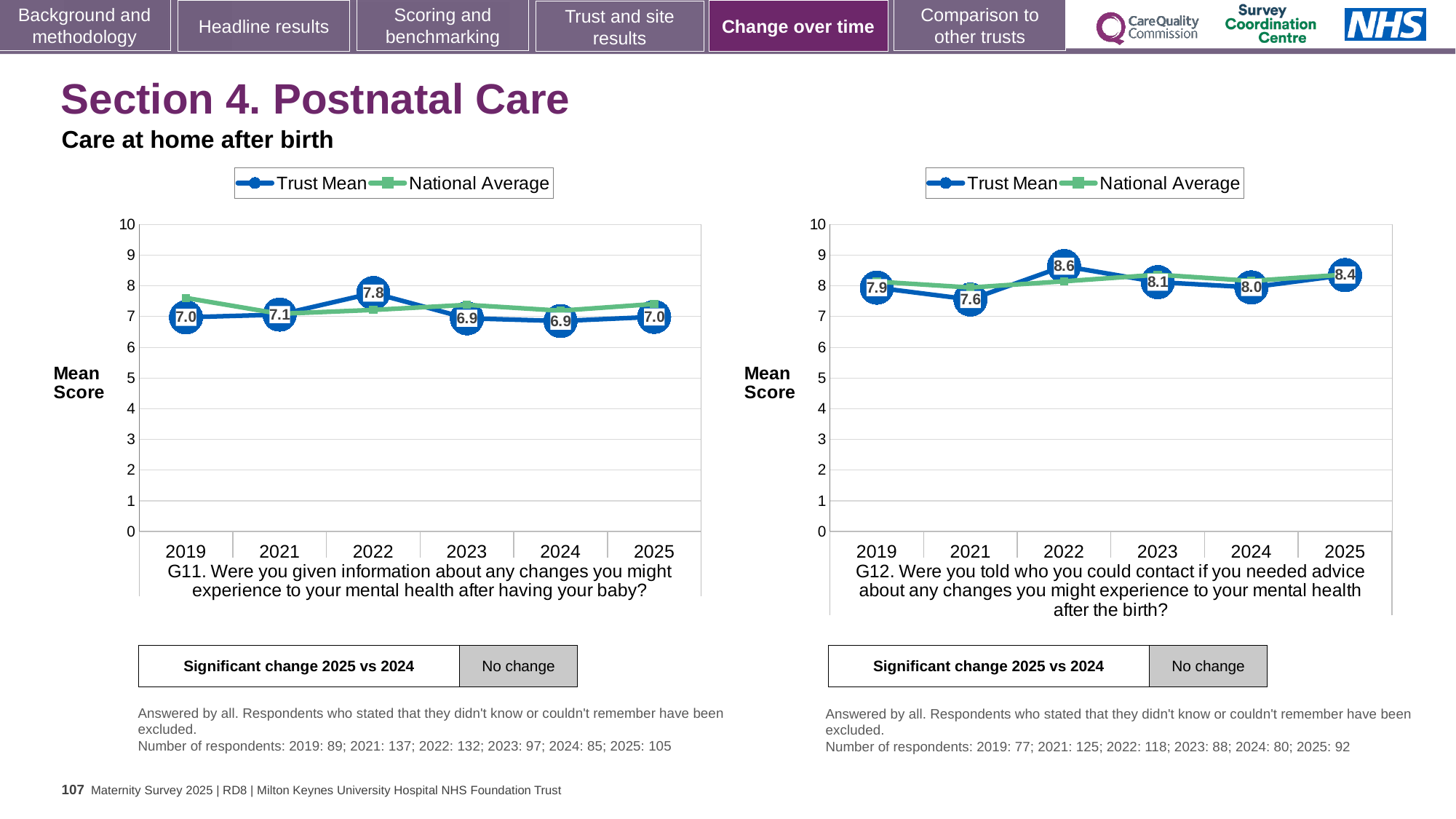
How many years are shown on the x axis of the left chart (G11)? 6 What type of chart is used for G11 on the left? Line chart On the right chart (G12), what is the difference between the Trust Mean scores for 2022 and 2021? 1.0 How many series does the legend of the right chart (G12) list? 2 On the left chart (G11), what is the Trust Mean score for 2022? 7.8 What does the 'Significant change 2025 vs 2024' box below the left chart (G11) say? No change On the left chart (G11), which year has the highest Trust Mean score? 2022 On the right chart (G12), does the Trust Mean score rise or fall from 2024 to 2025? rise On the right chart (G12), is the National Average for 2019 greater or less than 6? greater On the right chart (G12), what is the Trust Mean score for 2021? 7.6 On the left chart (G11), is the Trust Mean score for 2025 higher or lower than the Trust Mean score for 2022? lower On the right chart (G12), which year has the lowest Trust Mean score? 2021